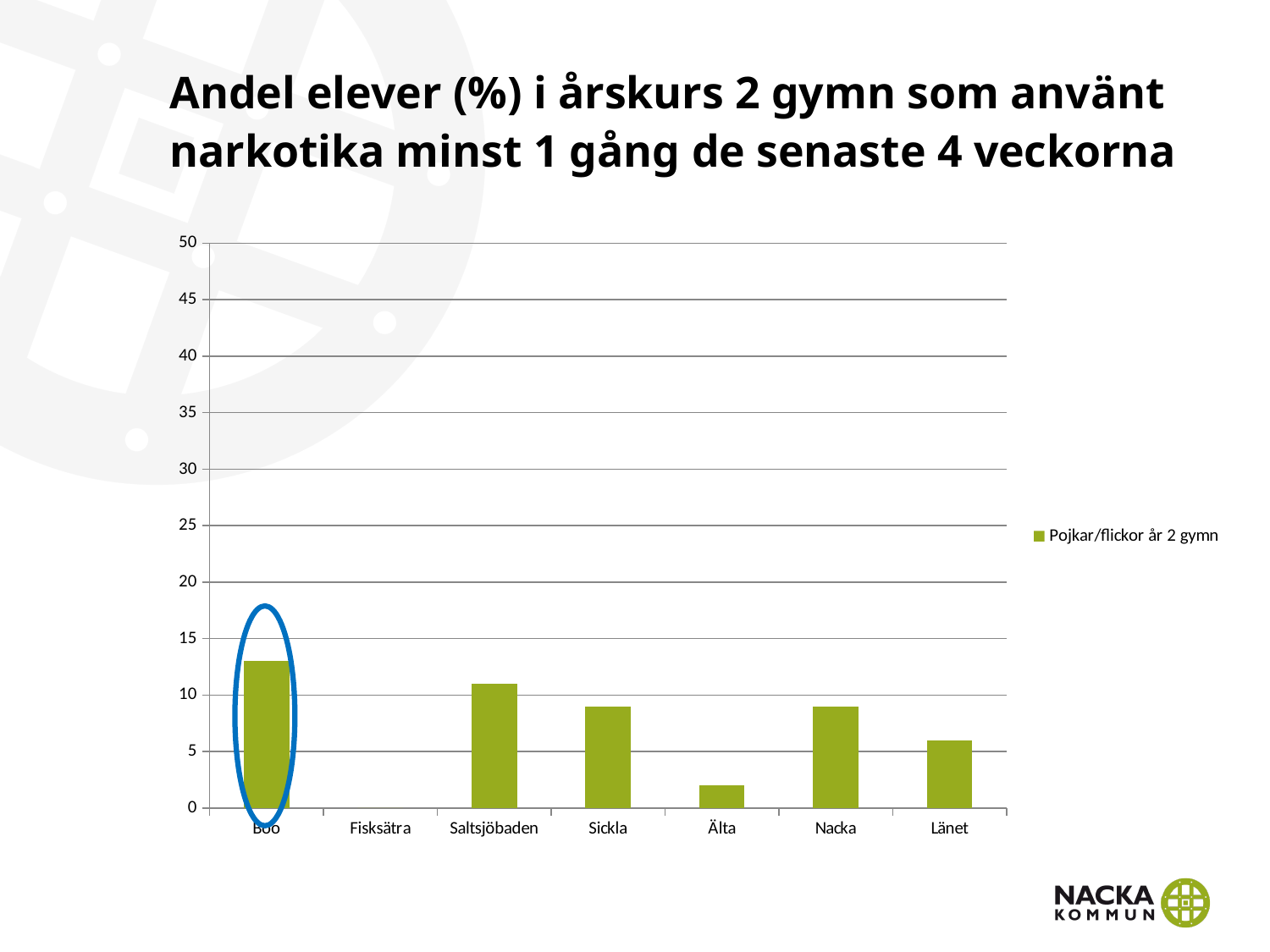
Which is larger, the value for Boo or the value for Saltsjöbaden? Boo What kind of chart is shown on the slide? bar chart How many series does the legend list? 1 Which category's bar is circled in blue on the chart? Boo Is the value for Boo greater or less than 10? greater What is the series name shown in the chart legend? Pojkar/flickor år 2 gymn Is the value for Nacka greater or less than 10? less How many categories are shown on the x axis of the chart? 7 Is the value for Sickla greater or less than 5? greater Which is larger, the value for Länet or the value for Älta? Länet Which category has the highest bar in the chart? Boo